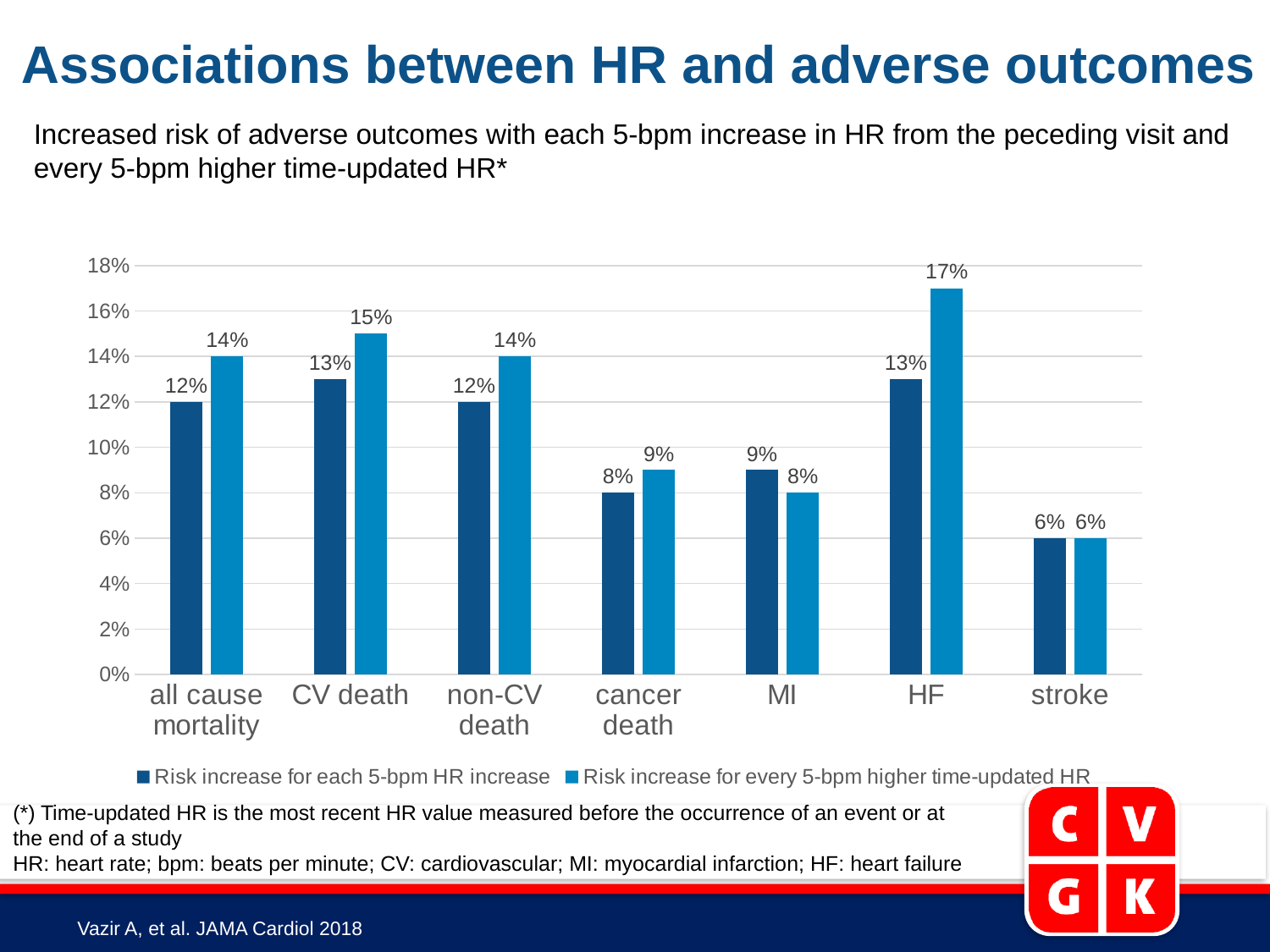
What is the risk increase for every 5-bpm higher time-updated HR for CV death? 15% What kind of chart is shown on the slide? Bar chart For cancer death, which series has the larger value: risk increase for each 5-bpm HR increase or risk increase for every 5-bpm higher time-updated HR? Risk increase for every 5-bpm higher time-updated HR What is the risk increase for each 5-bpm HR increase for MI? 9% How many outcome categories are shown on the x axis? 7 How many series does the legend list? 2 Which category has the highest risk increase for every 5-bpm higher time-updated HR? HF What is the difference between the risk increase for each 5-bpm HR increase for CV death and for stroke? 7% What is the difference between the two series' values for HF? 4% What is the risk increase for each 5-bpm HR increase for all cause mortality? 12% Which category has the lowest risk increase for each 5-bpm HR increase? stroke What is the risk increase for every 5-bpm higher time-updated HR for HF? 17%